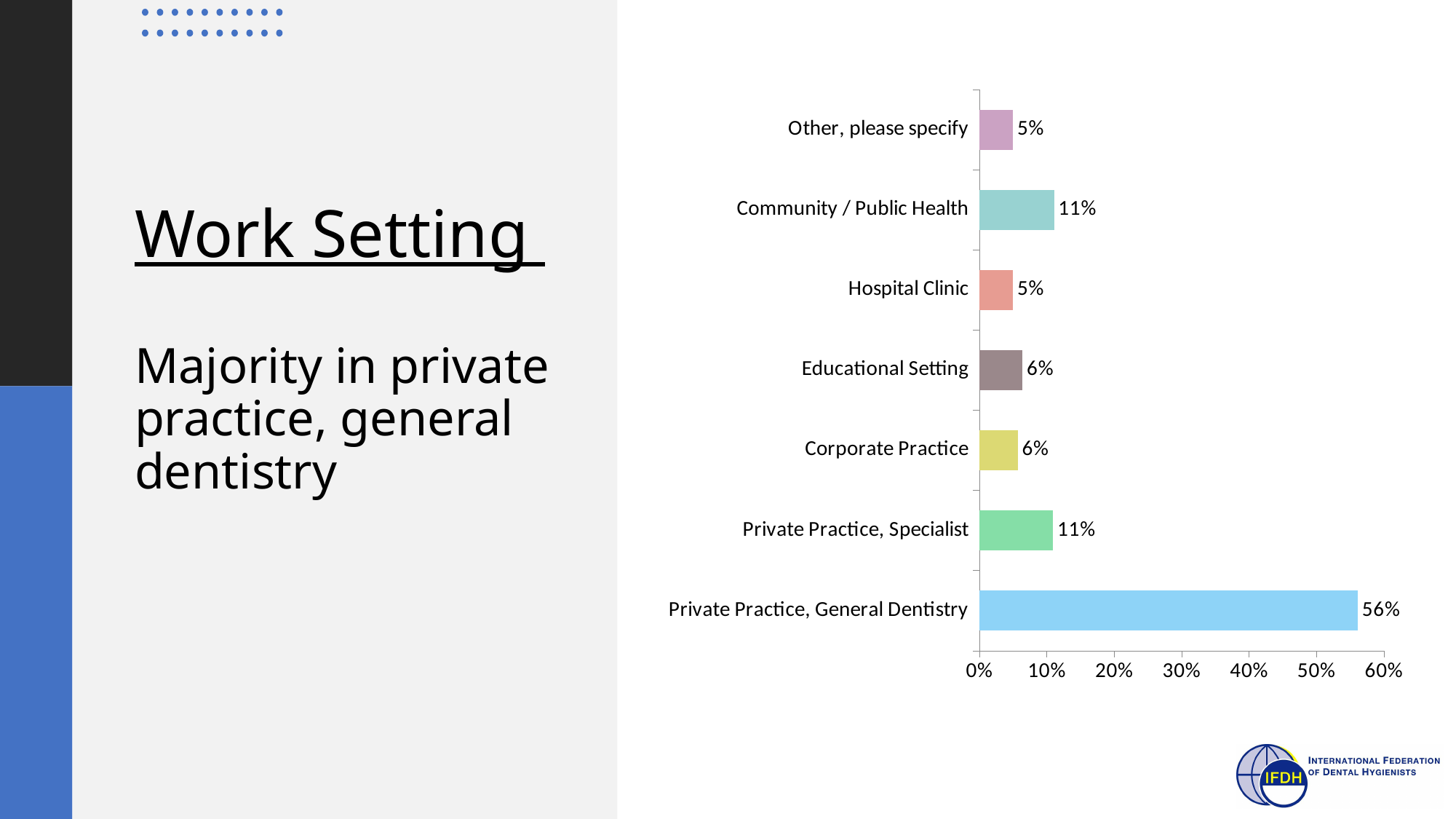
What is the difference between Private Practice, General Dentistry and Private Practice, Specialist? 45% Which category has the highest value? Private Practice, General Dentistry Which is larger, Private Practice, Specialist or Hospital Clinic? Private Practice, Specialist What is the value for Private Practice, General Dentistry? 56% What is the value for Educational Setting? 6% What is the maximum value shown on the horizontal axis? 60% What is the value for Hospital Clinic? 5% What is the difference between Community / Public Health and Corporate Practice? 5% How many categories are shown in the chart? 7 Is the value for Private Practice, General Dentistry greater or less than 50%? greater What is the value for Community / Public Health? 11% What kind of chart is shown on the slide? bar chart